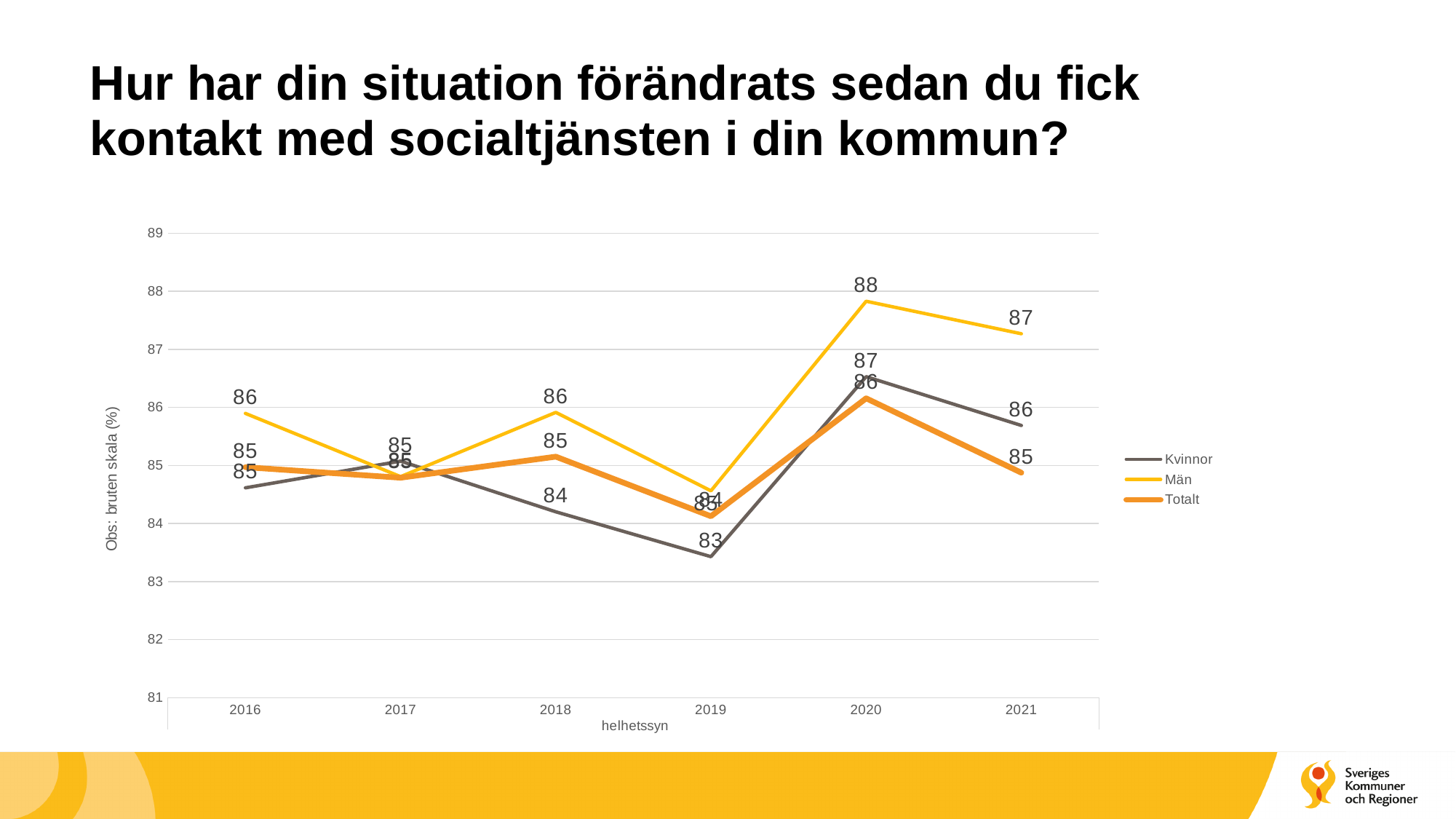
What is the value for Män in 2020? 88 What is the value for Kvinnor in 2019? 83 What is the value for Kvinnor in 2021? 86 In which year is the value for Män highest? 2020 How many series does the legend list? 3 How many years are shown on the x axis? 6 What is the difference between Män and Totalt in 2021? 2 What is the value for Män in 2021? 87 In 2018, which is larger, Män or Kvinnor? Män What type of chart is shown on the slide? line chart What are the three legend entries? Kvinnor, Män, Totalt In which year is the value for Kvinnor lowest? 2019